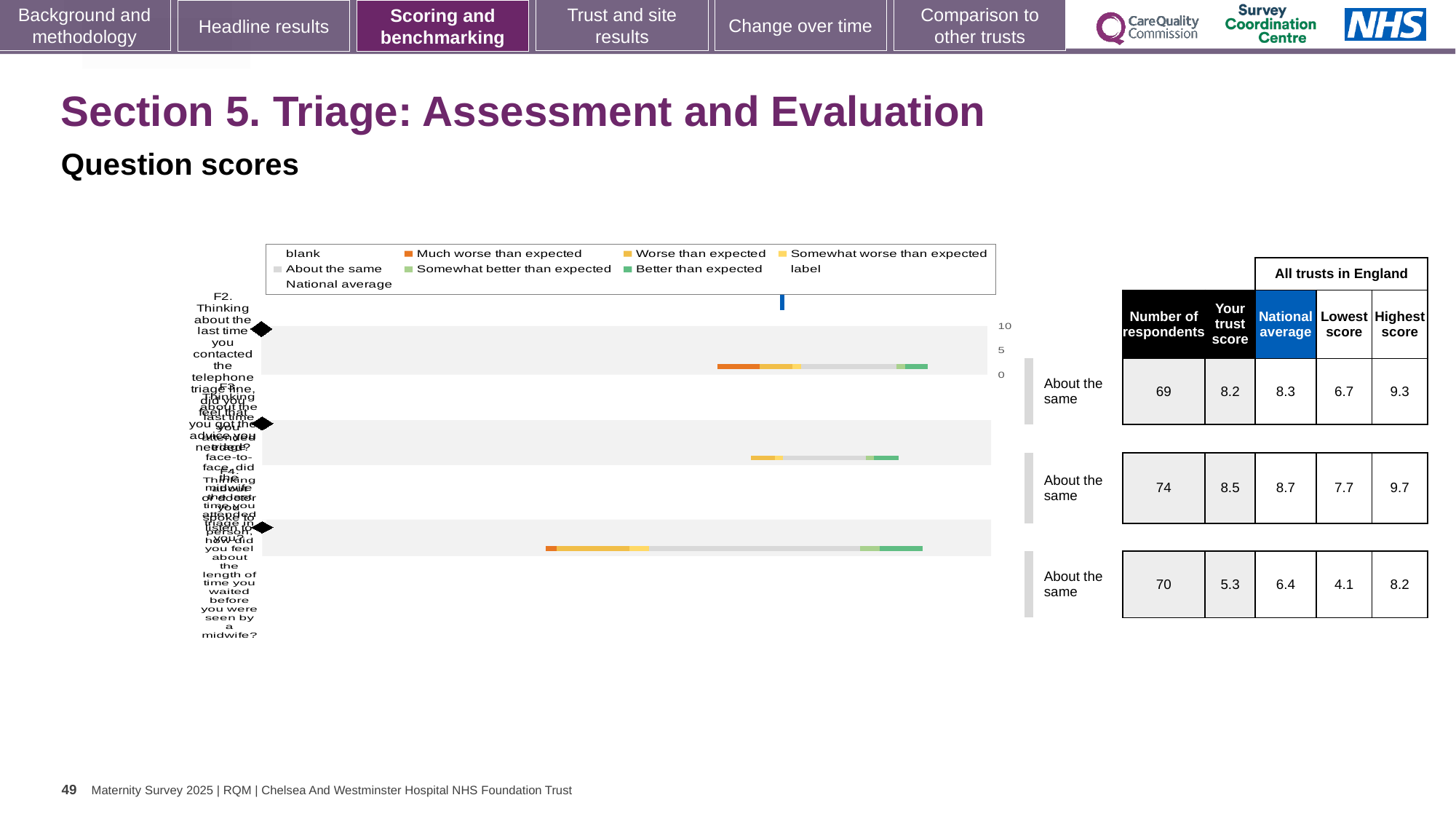
What is the national average for the middle row of the chart? 8.7 What is the number of respondents for the bottom row of the chart? 70 For the middle row of the chart, which is larger: the trust score or the national average? the national average Which row of the chart has the lowest 'Your trust score'? the bottom row What is the lowest score across all trusts in England for the bottom row of the chart? 4.1 What colour does the legend use for 'Better than expected'? green What colour does the legend use for 'Much worse than expected'? orange What kind of chart is shown on the slide? bar chart How many question rows (bars) does the chart show? 3 For the bottom row of the chart, what is the difference between the national average and the trust score? 1.1 What is the 'Your trust score' for the top row of the chart? 8.2 Which row of the chart has the highest 'Highest score'? the middle row